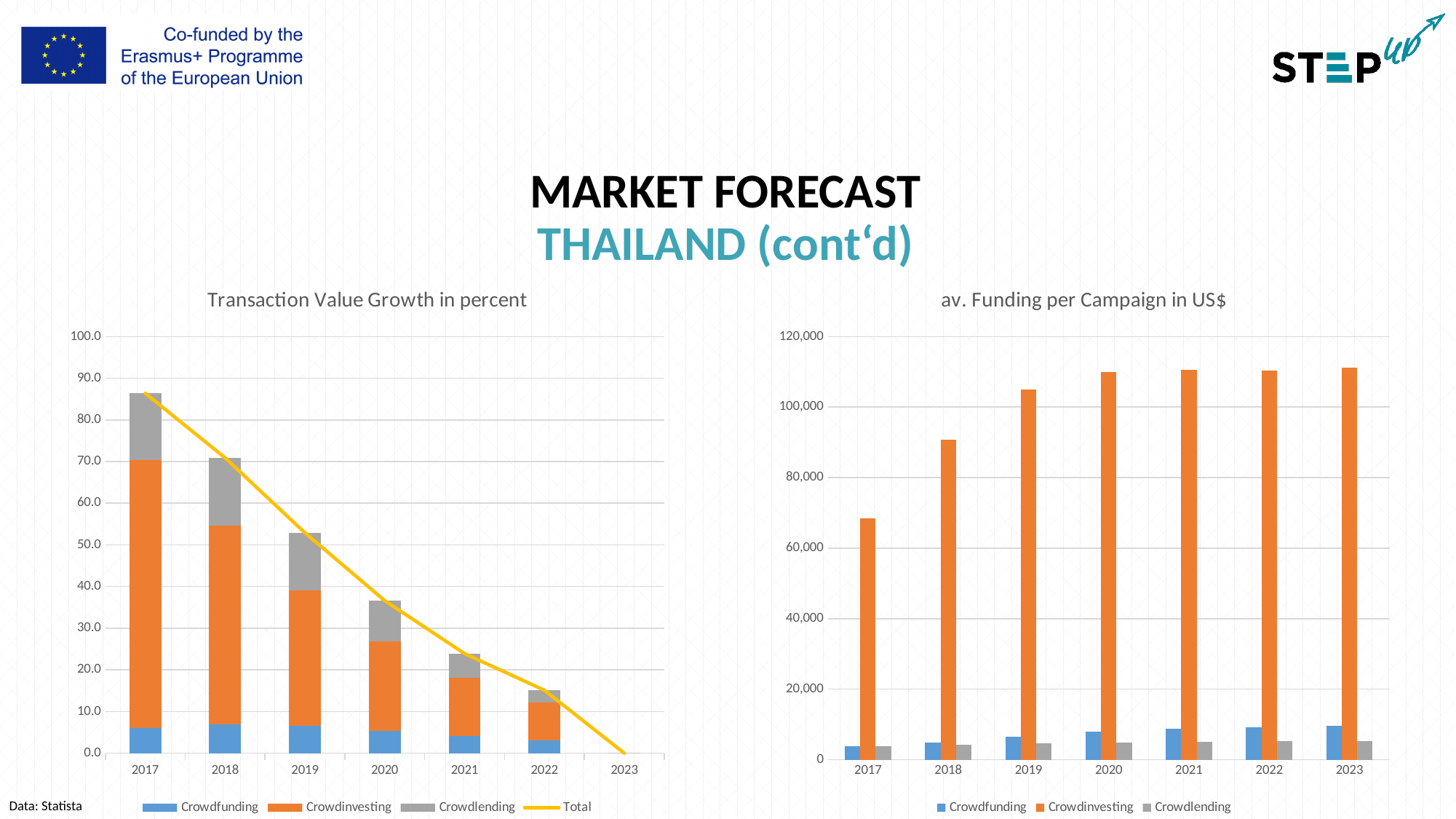
How many years are shown on the x axis of the 'av. Funding per Campaign in US$' chart? 7 In the 'Transaction Value Growth in percent' chart, is the Total for 2019 greater or less than 60.0? less In the 'av. Funding per Campaign in US$' chart, which year has the lowest Crowdinvesting value? 2017 How many series does the legend of the 'Transaction Value Growth in percent' chart list? 4 In the 'av. Funding per Campaign in US$' chart, is the Crowdinvesting value for 2018 greater or less than 100,000? less How many series does the legend of the 'av. Funding per Campaign in US$' chart list? 3 What kind of chart is the 'Transaction Value Growth in percent' chart on the left? stacked bar chart with a line In the 'av. Funding per Campaign in US$' chart, is the Crowdinvesting value larger in 2018 or 2019? 2019 In the 'Transaction Value Growth in percent' chart, does the Total rise or fall from 2017 to 2023? fall In the 'Transaction Value Growth in percent' chart, is the Total for 2017 greater or less than 80.0? greater In the 'Transaction Value Growth in percent' chart, which series is shown by the yellow line? Total In the 'Transaction Value Growth in percent' chart, which year has the highest Total? 2017